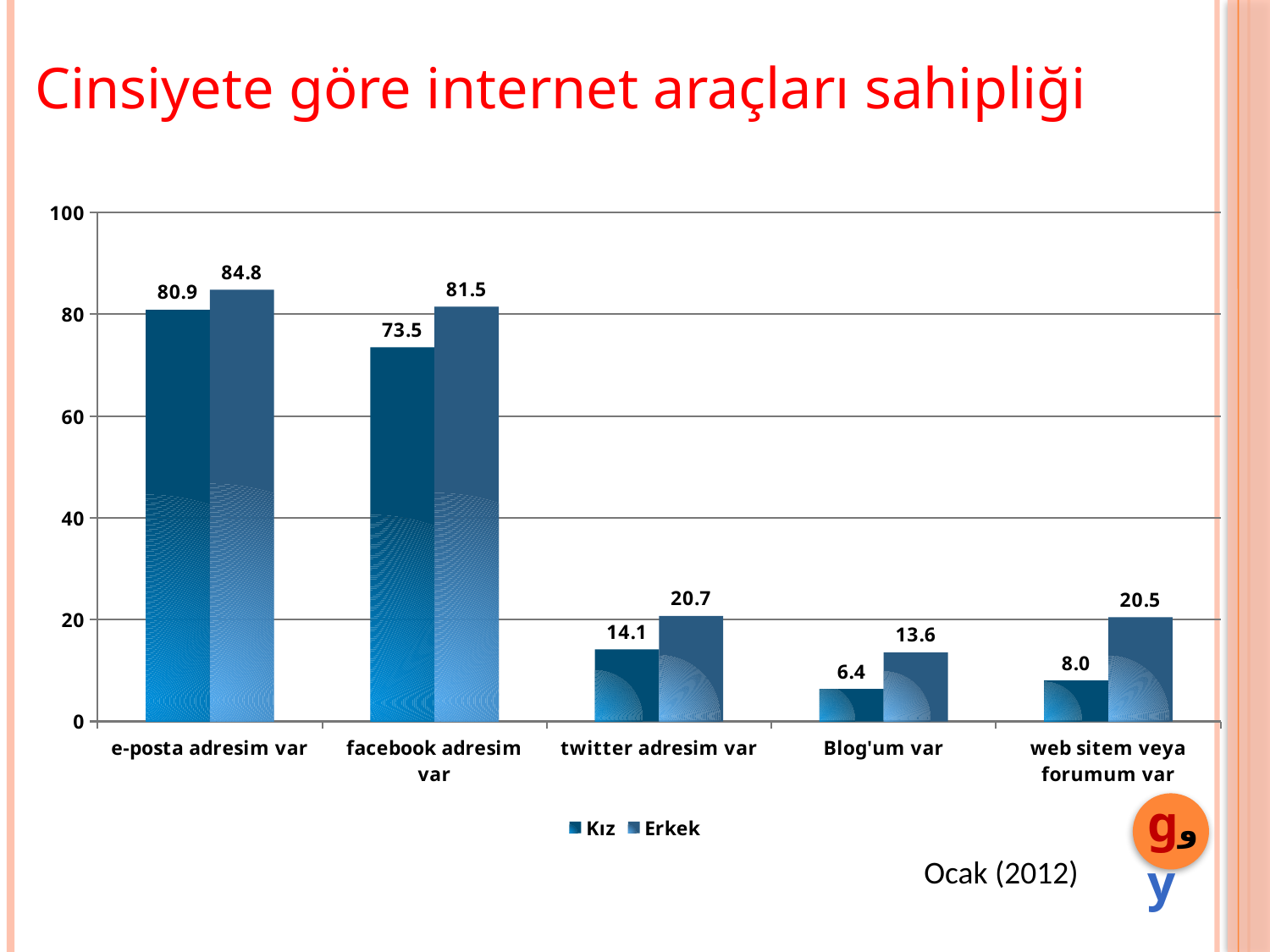
What is the difference between the Erkek and Kız values in the 'facebook adresim var' category? 8.0 How many categories are shown on the x axis? 5 What is the value for Erkek in the 'twitter adresim var' category? 20.7 What kind of chart is shown on the slide? bar chart Which is larger in the 'web sitem veya forumum var' category, Kız or Erkek? Erkek How many series does the legend list? 2 Is the Erkek value for 'Blog'um var' greater or less than 20? less What is the title of the slide? Cinsiyete göre internet araçları sahipliği What is the value for Kız in the 'Blog'um var' category? 6.4 Which category has the lowest value for Kız? Blog'um var Which category has the highest value for Erkek? e-posta adresim var What is the value for Kız in the 'e-posta adresim var' category? 80.9